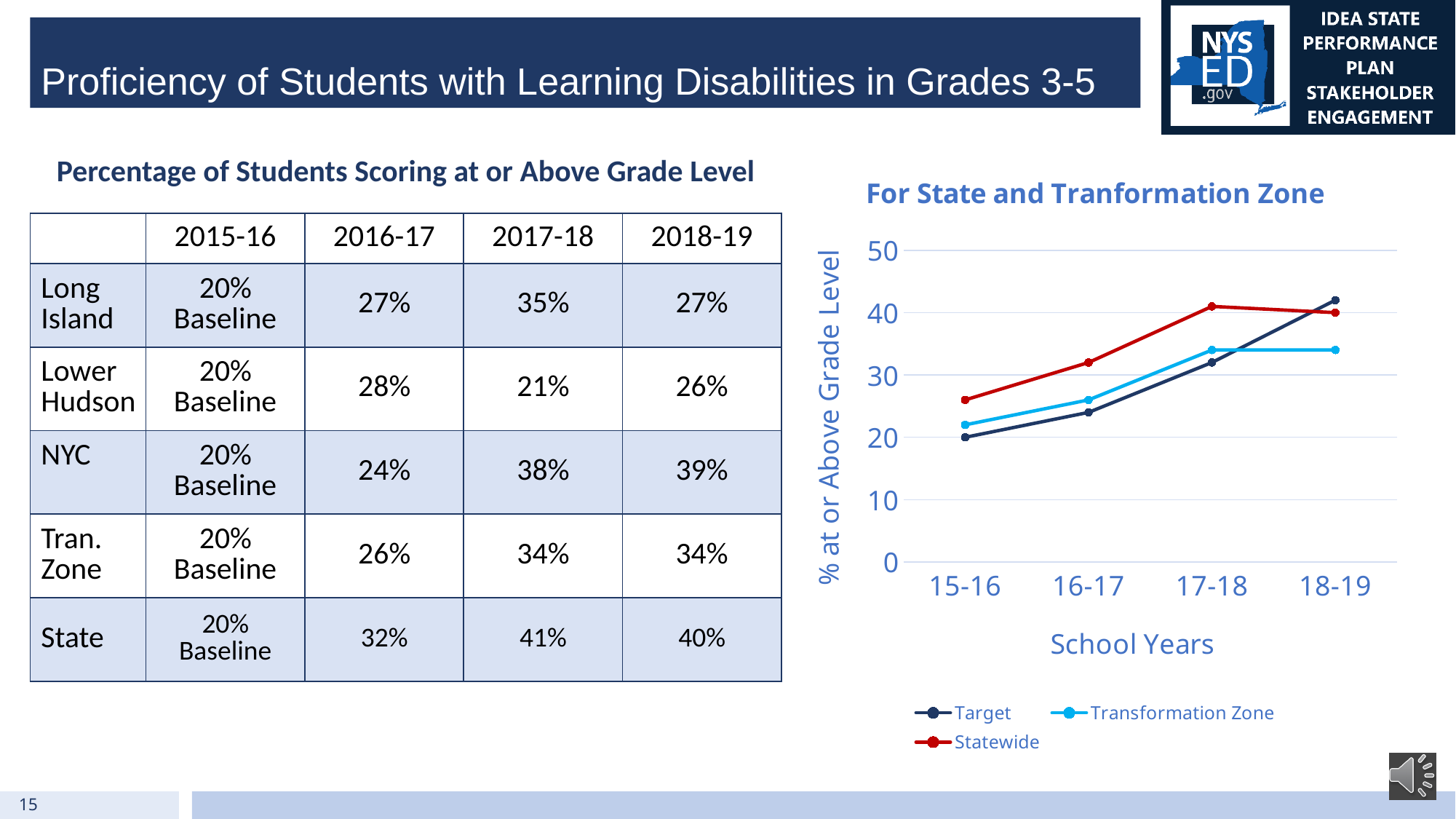
Which series has the lowest value in 16-17? Target Is the Transformation Zone value for 18-19 greater or less than 40? less Which series has the highest value in 15-16? Statewide How many school years are plotted along the x axis of the chart? 4 What is the title of the chart? For State and Tranformation Zone How many series does the chart legend list? 3 What is the value of the Target series for 15-16? 20 What kind of chart is shown on the slide? line chart In 18-19, which is larger: the Target value or the Transformation Zone value? Target Does the Statewide series rise or fall from 15-16 to 17-18? rise Is the Statewide value for 17-18 greater or less than 40? greater Is the Target value for 16-17 greater or less than 30? less